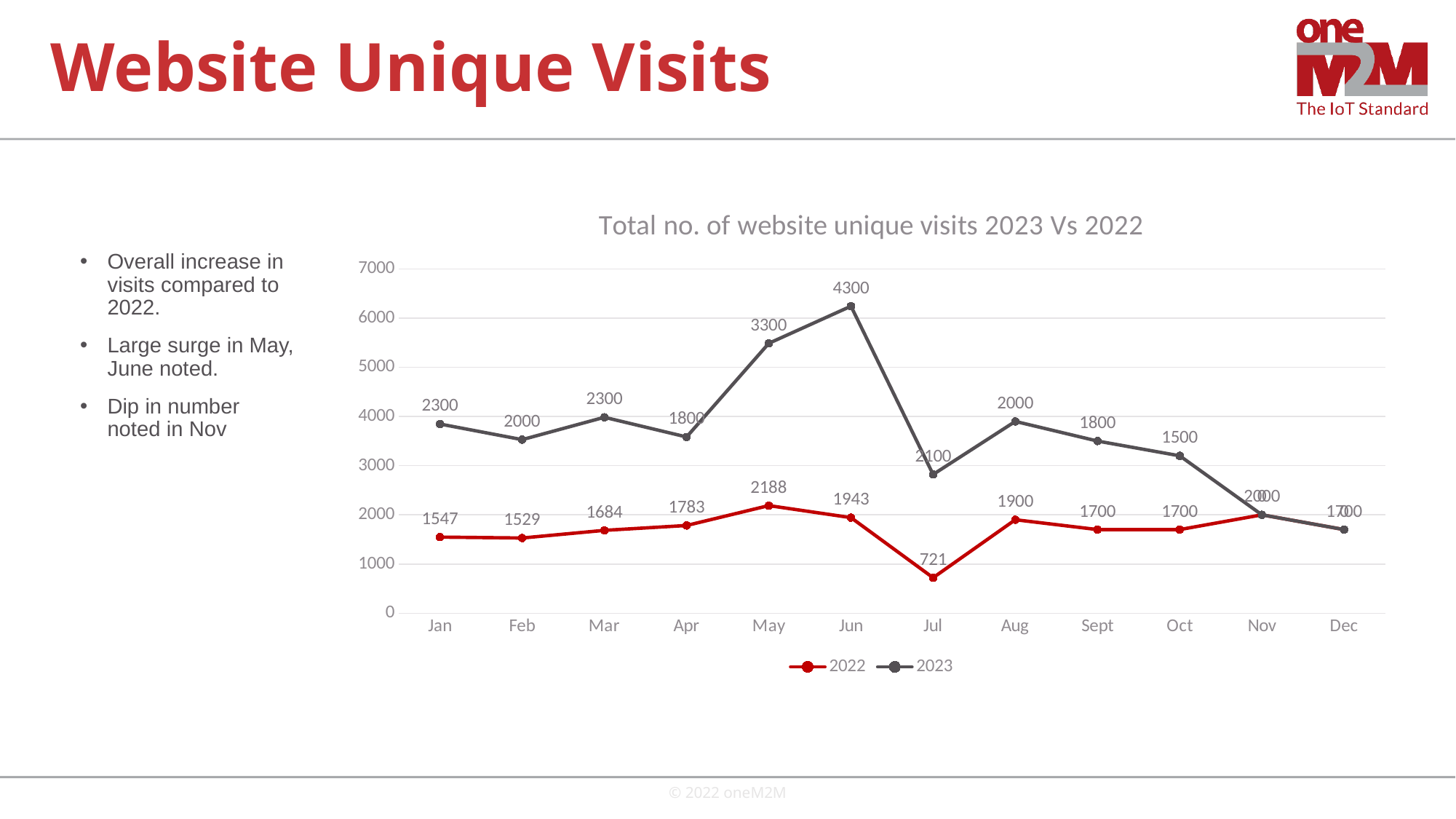
What is the 2022 value for May? 2188 How many series does the legend list? 2 In which month is the 2022 series lowest? Jul What kind of chart is shown on the slide? Line chart Is the 2022 value for Jul greater or less than 1000? less What is the title of the chart? Total no. of website unique visits 2023 Vs 2022 What is the difference between the 2022 values for May and Jul? 1467 What is the data label for 2023 in Jun? 4300 Which colour is used for the 2022 series? Red In which month is the 2022 series highest? May What is the 2022 value for Jul? 721 How many months are shown on the x axis? 12